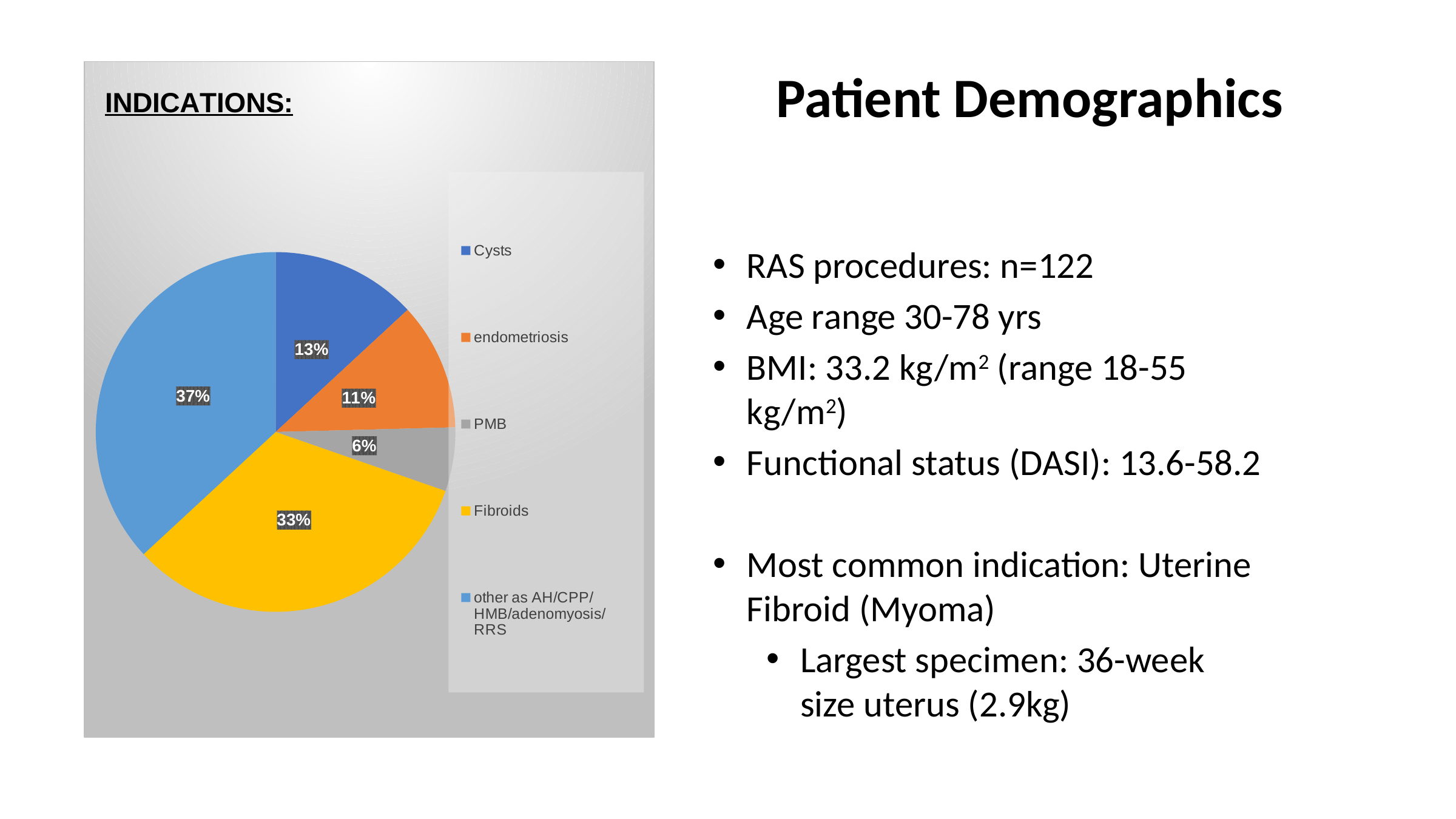
Which category has the smallest share of the pie? PMB How many categories does the pie chart show? 5 What percentage of the pie is 'other as AH/CPP/HMB/adenomyosis/RRS'? 37% What is the title of the chart? INDICATIONS: Which category has the largest share of the pie? other as AH/CPP/HMB/adenomyosis/RRS What type of chart is shown on the slide? pie chart What percentage of the pie is Fibroids? 33% What percentage of the pie is Cysts? 13% What percentage of the pie is PMB? 6% Which is larger, the share for endometriosis or the share for PMB? endometriosis What is the difference in percentage points between Fibroids and Cysts? 20 What percentage of the pie is endometriosis? 11%